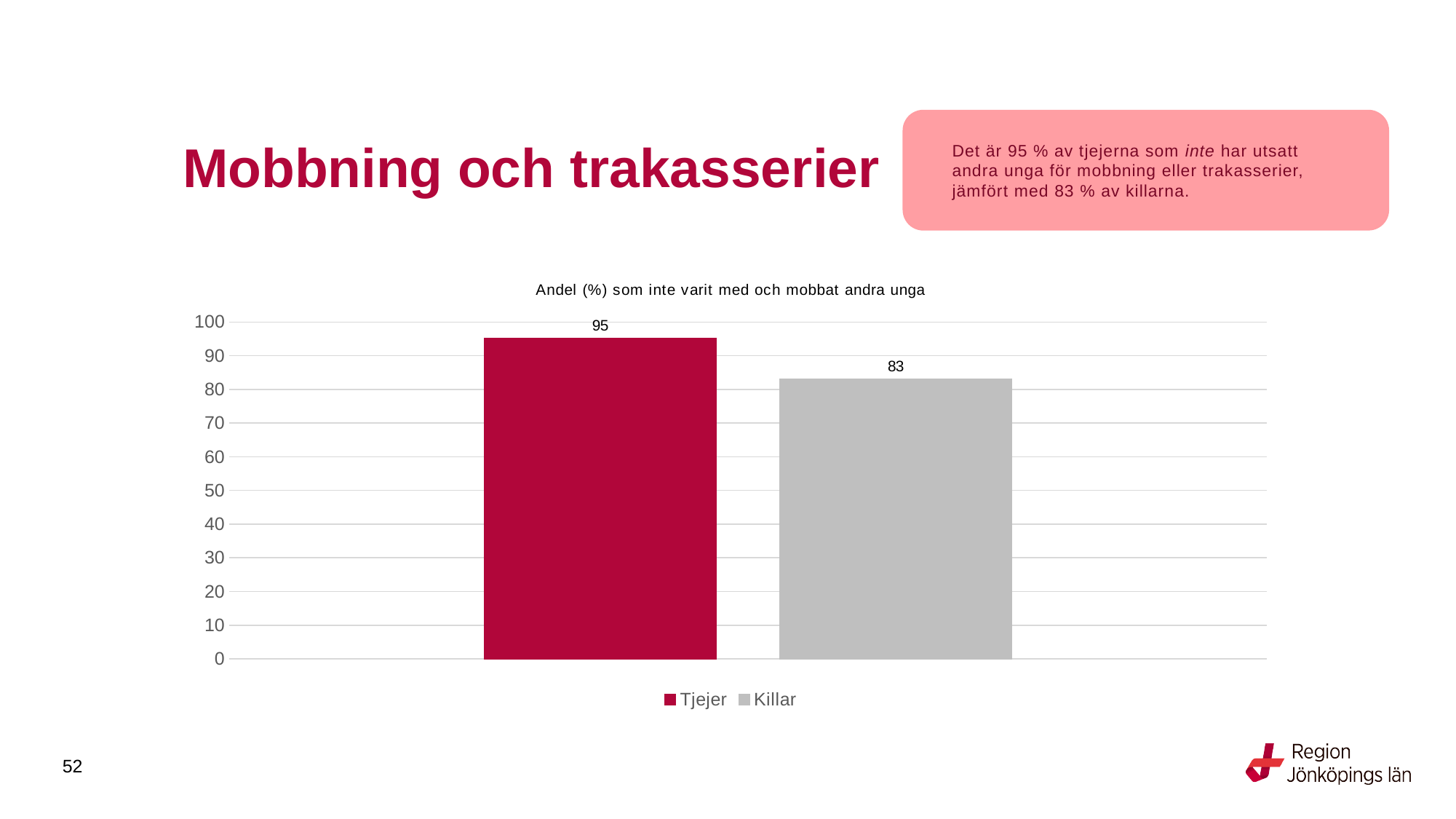
Which series has the lowest value? Killar What is the title of the chart? Andel (%) som inte varit med och mobbat andra unga How many bars are plotted in the chart? 2 Is the value for Killar greater or less than 90? less Which series has the highest value? Tjejer What is the value for Tjejer? 95 Which is larger, the value for Tjejer or the value for Killar? Tjejer What is the difference between the values for Tjejer and Killar? 12 What kind of chart is shown on the slide? Bar chart Is the value for Tjejer greater or less than 90? greater How many series does the legend list? 2 What is the value for Killar? 83